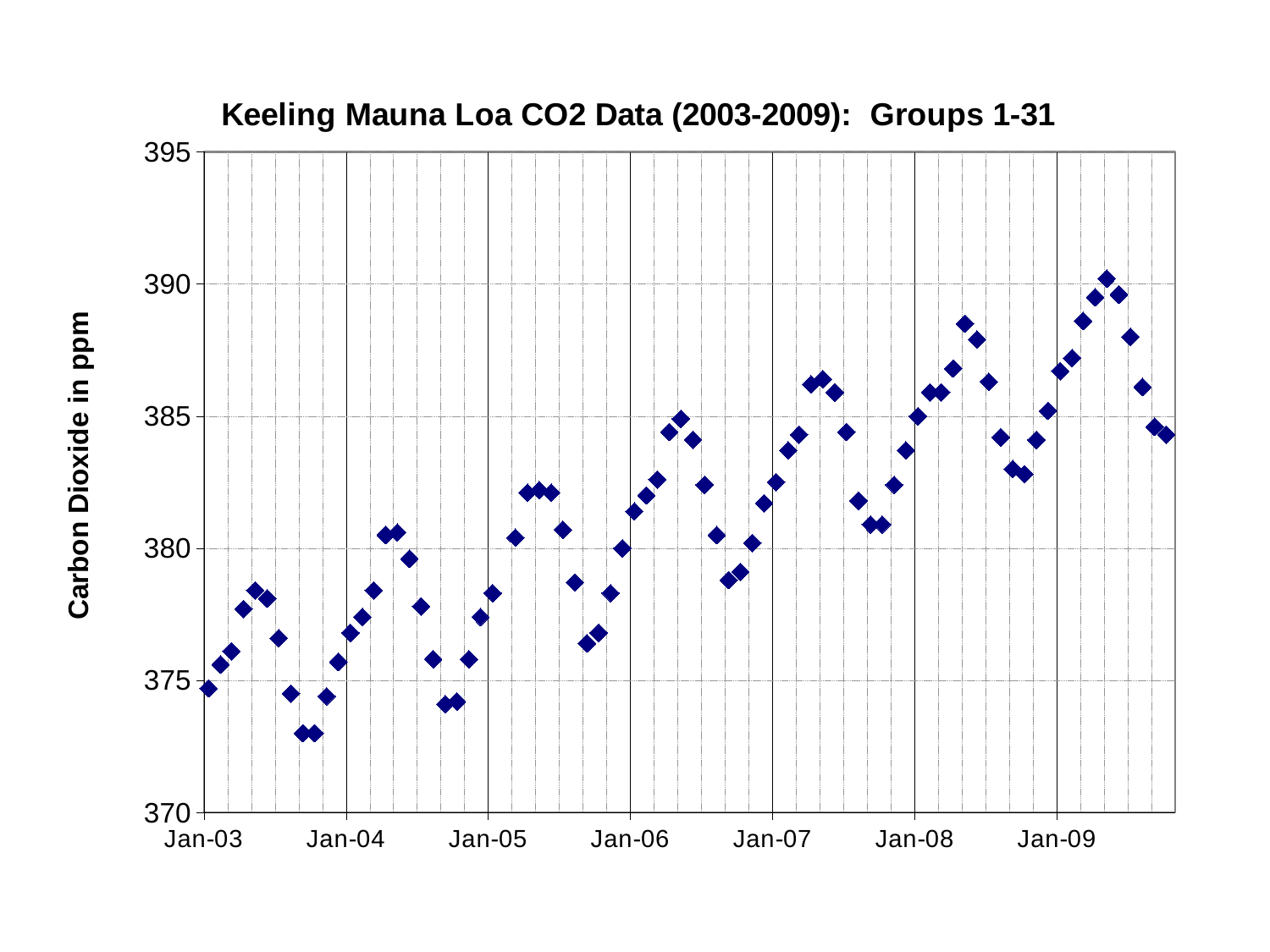
What is the title of the chart? Keeling Mauna Loa CO2 Data (2003-2009): Groups 1-31 What kind of chart is shown on the slide? scatter chart In which year does the chart reach its lowest plotted value? 2003 Is the highest point in 2009 greater or less than 385? greater In which year does the chart reach its highest plotted value? 2009 Is the value plotted at Jan-09 greater or less than 385? greater Overall, do the plotted values rise or fall from Jan-03 to Jan-09? rise Is the lowest point in 2003 greater or less than 375? less How many labelled tick marks are shown on the horizontal axis? 7 What is the label on the vertical axis of the chart? Carbon Dioxide in ppm Which is larger, the value plotted at Jan-09 or the value plotted at Jan-03? Jan-09